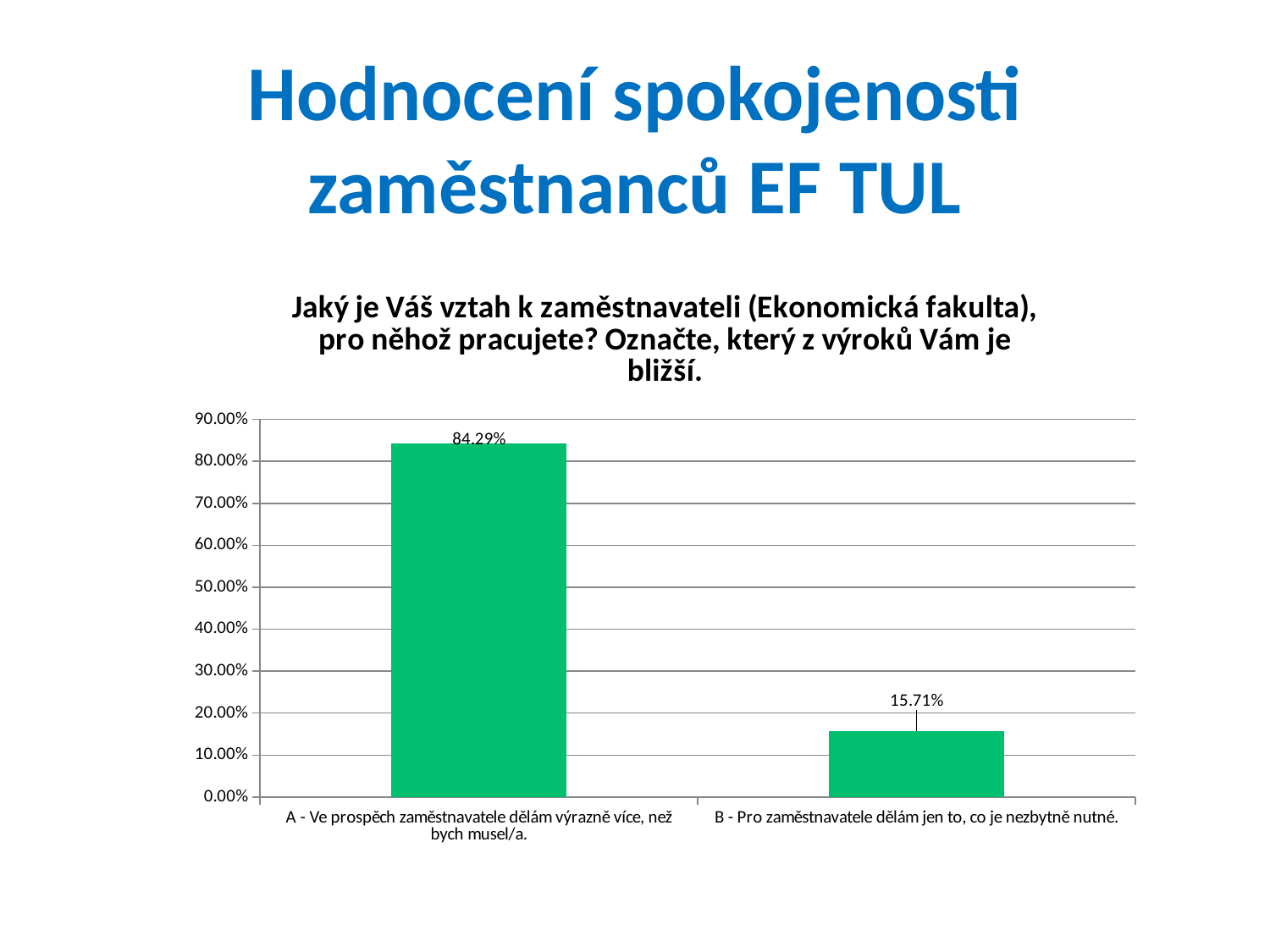
What kind of chart is shown on the slide? Bar chart What is the value for option B ("Pro zaměstnavatele dělám jen to, co je nezbytně nutné.")? 15.71% Is the value for option A greater or less than 80.00%? greater What is the total of the two values shown in the chart? 100.00% What is the value for option A ("Ve prospěch zaměstnavatele dělám výrazně více, než bych musel/a.")? 84.29% How many categories are shown in the chart? 2 Which option has the highest value? A - Ve prospěch zaměstnavatele dělám výrazně více, než bych musel/a. Is the value for option B greater or less than 20.00%? less Which is larger, the value for option A or option B? Option A Which option has the lowest value? B - Pro zaměstnavatele dělám jen to, co je nezbytně nutné. What is the difference between the values for option A and option B? 68.58% What is the maximum value shown on the vertical axis? 90.00%